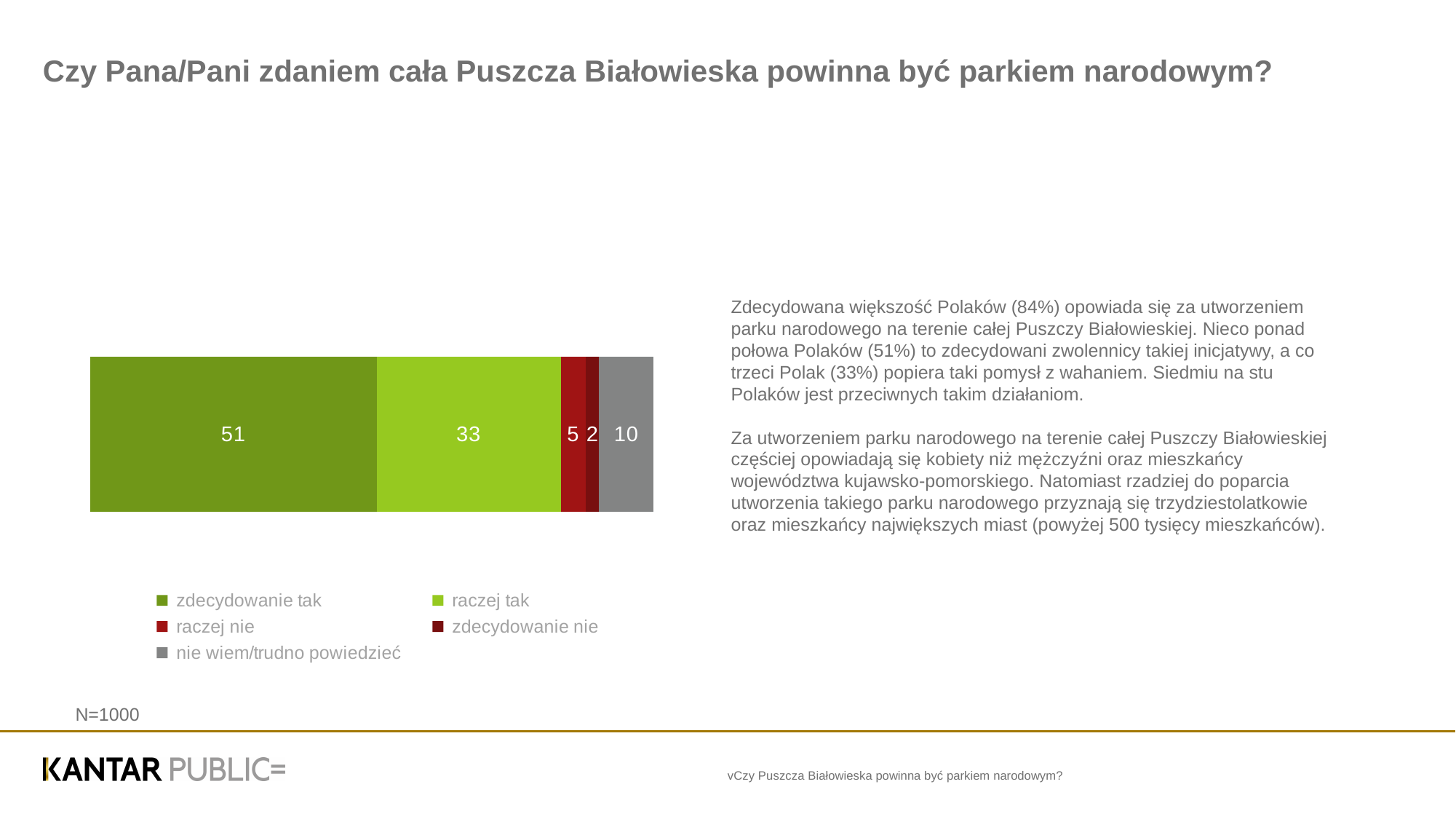
What is the difference between the values for "zdecydowanie tak" and "raczej tak"? 18 What value is shown for "nie wiem/trudno powiedzieć" in the chart? 10 What value is shown for "raczej nie" in the chart? 5 What value is shown for "zdecydowanie nie" in the chart? 2 What value is shown for "raczej tak" in the chart? 33 What is the total of all segments in the stacked bar? 101 Which response category has the highest value in the chart? zdecydowanie tak What value is shown for "zdecydowanie tak" in the chart? 51 What kind of chart is shown on the slide? stacked bar chart Which is larger: the value for "nie wiem/trudno powiedzieć" or the value for "raczej nie"? nie wiem/trudno powiedzieć Which response category has the lowest value in the chart? zdecydowanie nie How many series does the legend list? 5